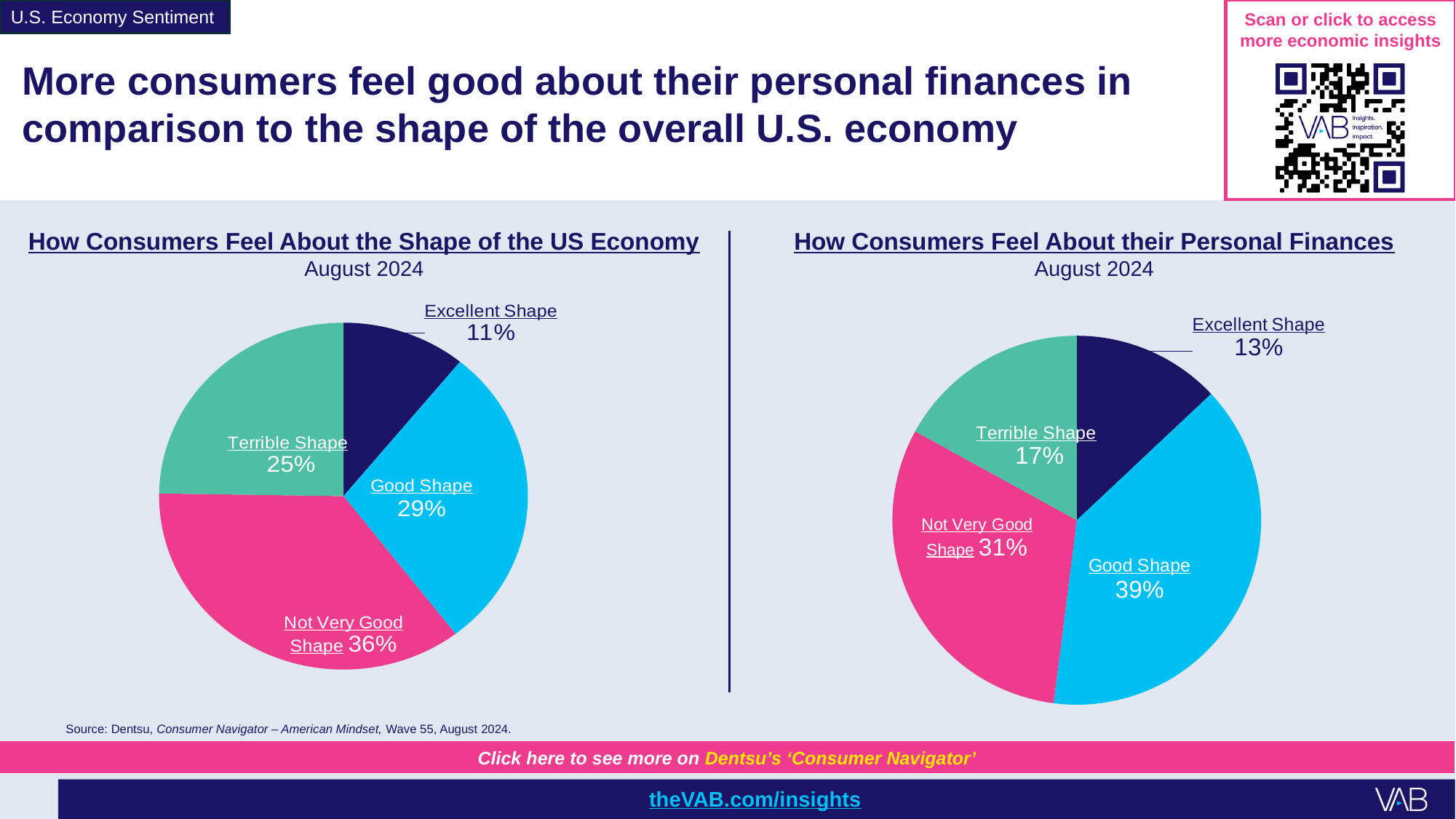
In the 'How Consumers Feel About the Shape of the US Economy' chart, what share of consumers say the economy is in Not Very Good Shape? 36% How many categories are shown in the 'How Consumers Feel About the Shape of the US Economy' pie chart? 4 In the 'How Consumers Feel About the Shape of the US Economy' chart, what colour is the Not Very Good Shape slice? Pink What month and year do both pie charts on the slide refer to? August 2024 In the 'How Consumers Feel About their Personal Finances' chart, what share of consumers say their finances are in Good Shape? 39% In the 'How Consumers Feel About the Shape of the US Economy' chart, what is the combined share of Excellent Shape and Good Shape? 40% What is the difference between the Good Shape share in the Personal Finances chart and the Good Shape share in the US Economy chart? 10 percentage points In the 'How Consumers Feel About their Personal Finances' chart, which category has the smallest slice? Excellent Shape Which is larger: the Terrible Shape share in the US Economy chart or the Terrible Shape share in the Personal Finances chart? US Economy chart (25%) In the 'How Consumers Feel About their Personal Finances' chart, what share of the pie is Terrible Shape? 17% What type of chart is used on the right side of the slide for 'How Consumers Feel About their Personal Finances'? Pie chart In the 'How Consumers Feel About the Shape of the US Economy' chart, which category has the largest slice? Not Very Good Shape